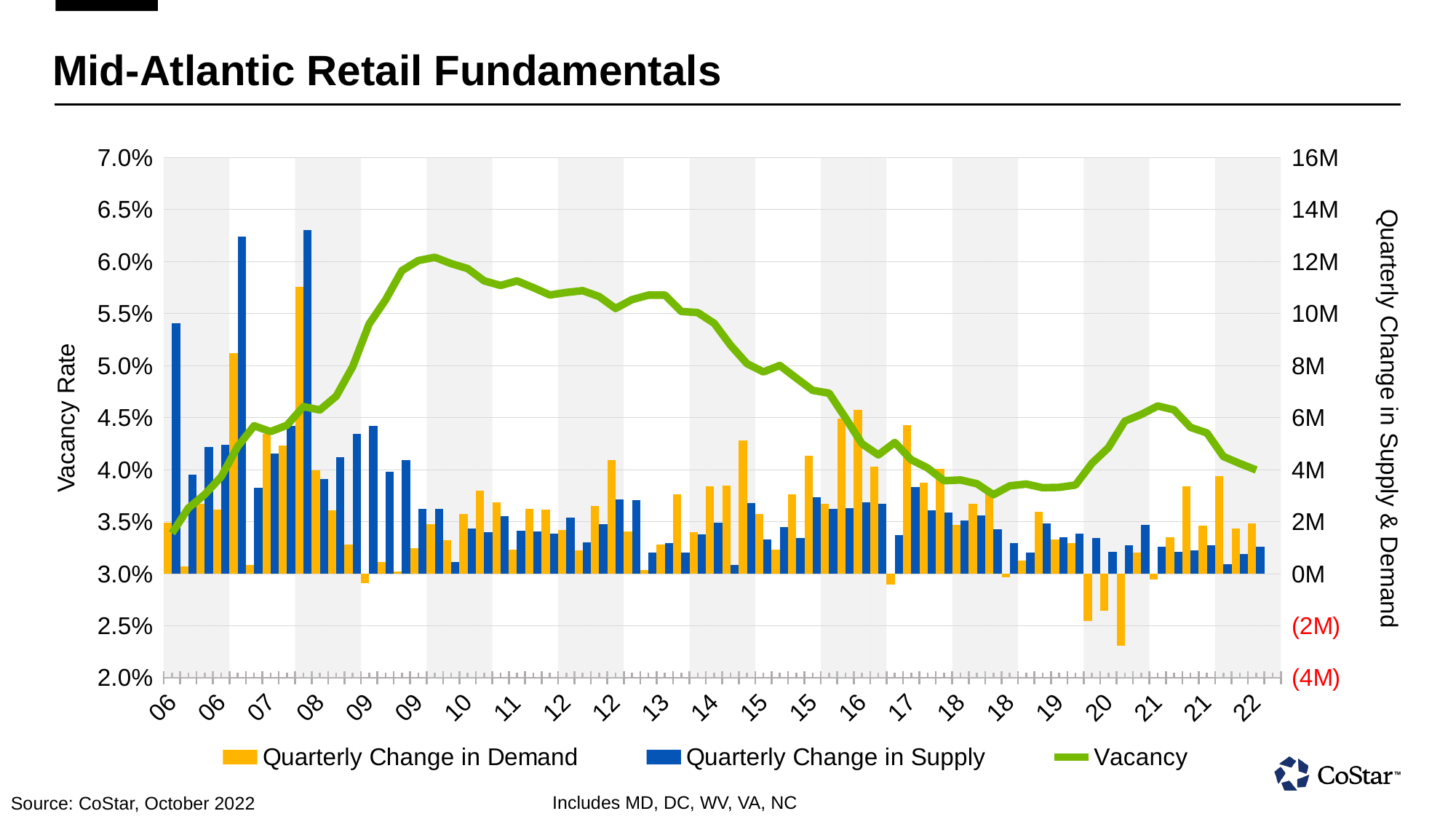
Is the peak Vacancy value around 2009 greater or less than 5.5%? greater What is the title of the chart? Mid-Atlantic Retail Fundamentals How many series does the legend list? 3 Which is larger: the tallest Quarterly Change in Supply bar or the tallest Quarterly Change in Demand bar? Quarterly Change in Supply What kind of chart is shown on the slide? A combined bar and line chart Is the tallest Quarterly Change in Supply bar, in 2008, greater or less than 12M? greater Does the Vacancy line rise or fall between 2006 and 2009? Rises Is the Vacancy value at the start of 2006 greater or less than 4.0%? less Does the Vacancy line rise or fall between 2009 and 2018? Falls Which series is plotted as a line rather than bars? Vacancy